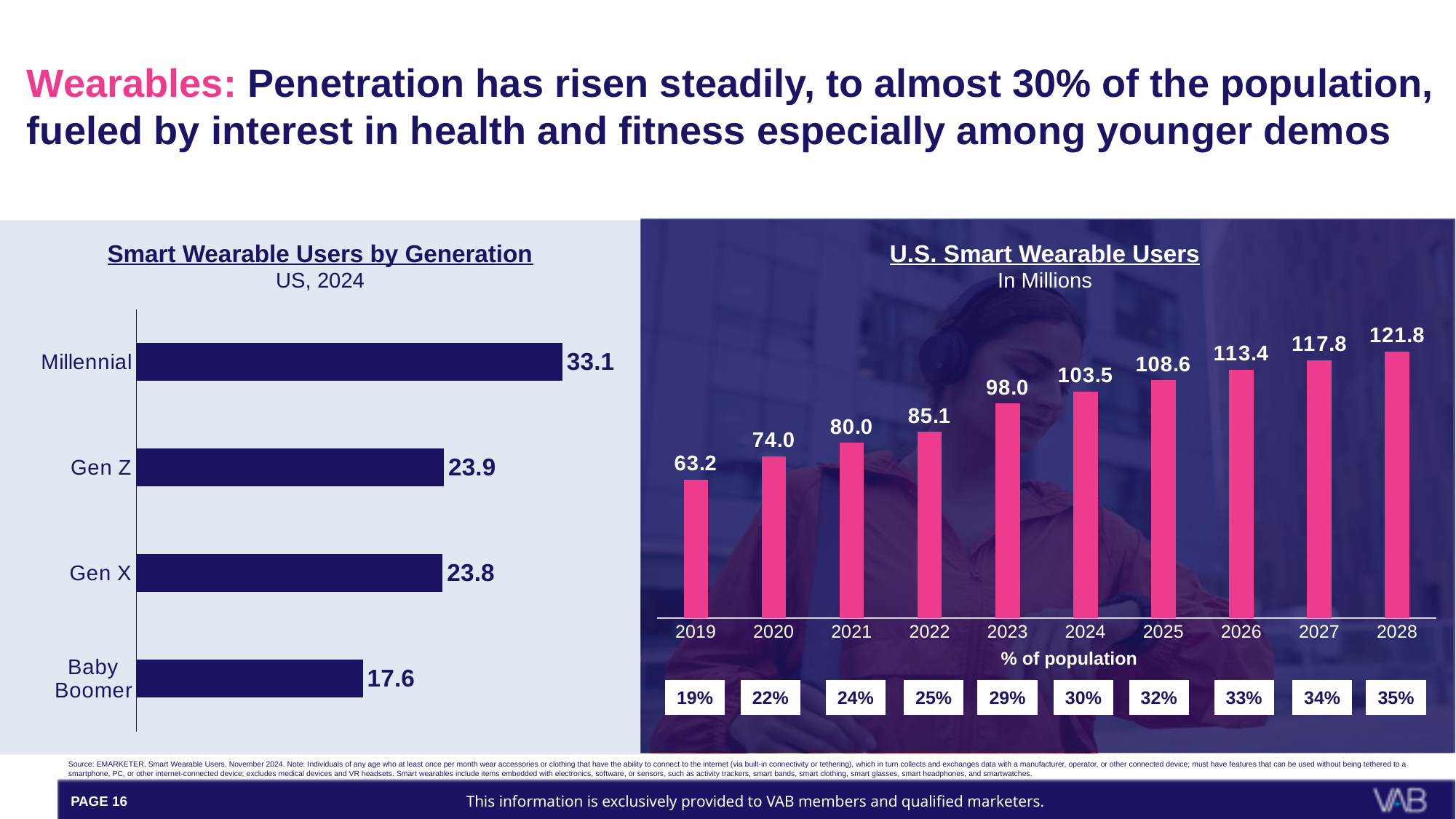
In the 'Smart Wearable Users by Generation' chart, how many generations are shown? 4 In the 'Smart Wearable Users by Generation' chart, which generation has the lowest value? Baby Boomer In the 'U.S. Smart Wearable Users' chart, do the values rise or fall from 2019 to 2028? Rise In the 'Smart Wearable Users by Generation' chart, what is the difference between the Millennial and Baby Boomer values? 15.5 In the 'U.S. Smart Wearable Users' chart, what is the difference between the 2028 and 2019 values? 58.6 In the 'U.S. Smart Wearable Users' chart, what unit is given in the subtitle? In Millions In the 'U.S. Smart Wearable Users' chart, which year has the highest value? 2028 What kind of chart is the 'Smart Wearable Users by Generation' chart? Bar chart In the 'U.S. Smart Wearable Users' chart, how many years are shown? 10 In the 'Smart Wearable Users by Generation' chart, what is the value for Millennial? 33.1 In the 'U.S. Smart Wearable Users' chart, what is the value for 2023? 98.0 In the 'U.S. Smart Wearable Users' chart, what is the % of population shown for 2024? 30%